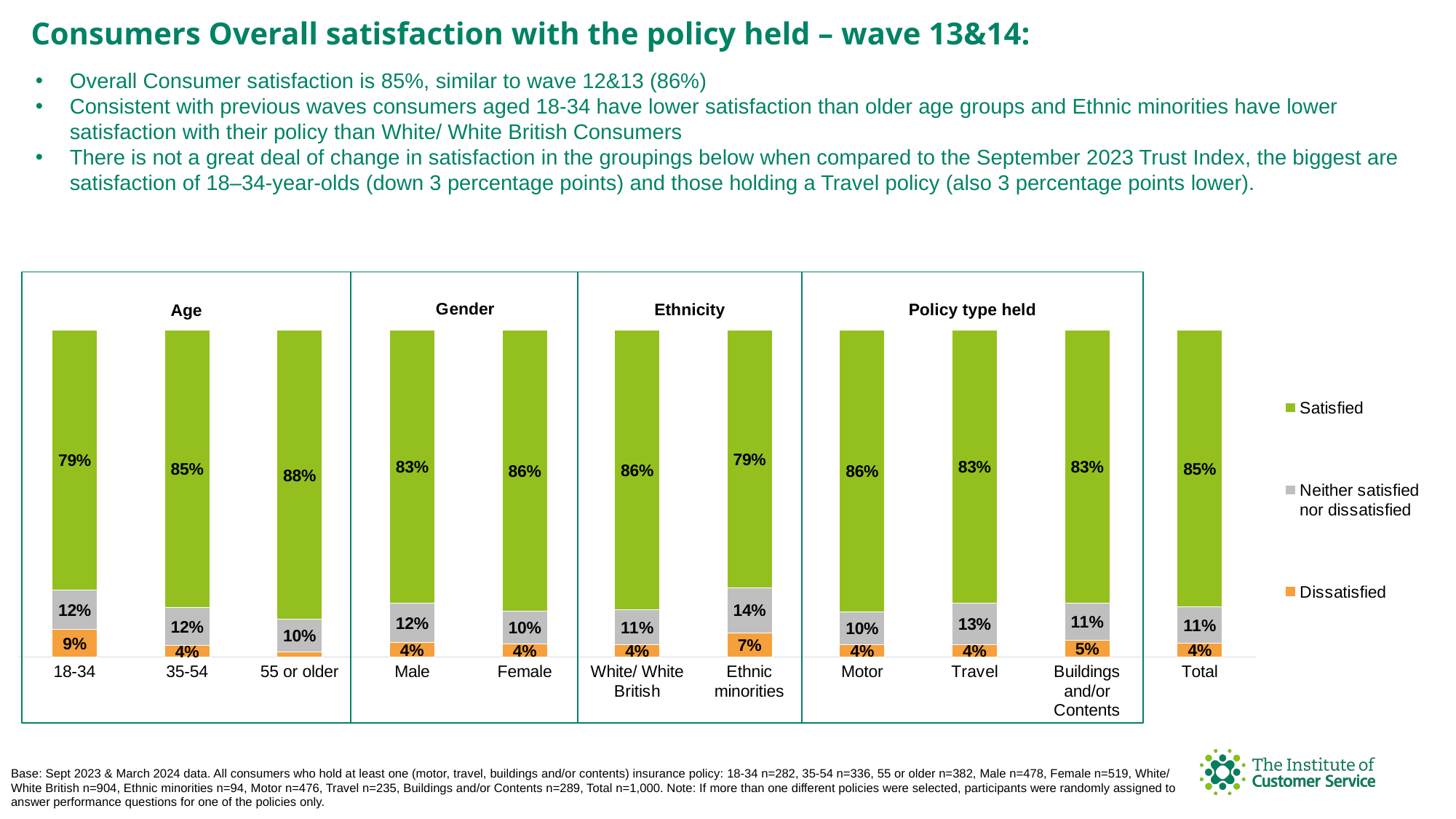
What is the Dissatisfied percentage for the 18-34 group? 9% How many categories are shown along the x axis of the chart? 11 How many series does the legend list? 3 Which has a higher Satisfied percentage, Motor or Travel? Motor What colour represents the Satisfied series in the chart? Green What is the Neither satisfied nor dissatisfied percentage for Ethnic minorities? 14% What is the difference in Satisfied percentage between White/ White British and Ethnic minorities? 7 percentage points Which category has the highest Satisfied percentage? 55 or older What type of chart is shown on the slide? Stacked bar chart What is the Satisfied percentage for the 55 or older group? 88% What is the Satisfied percentage for the Total bar? 85% Which category has the highest Dissatisfied percentage? 18-34